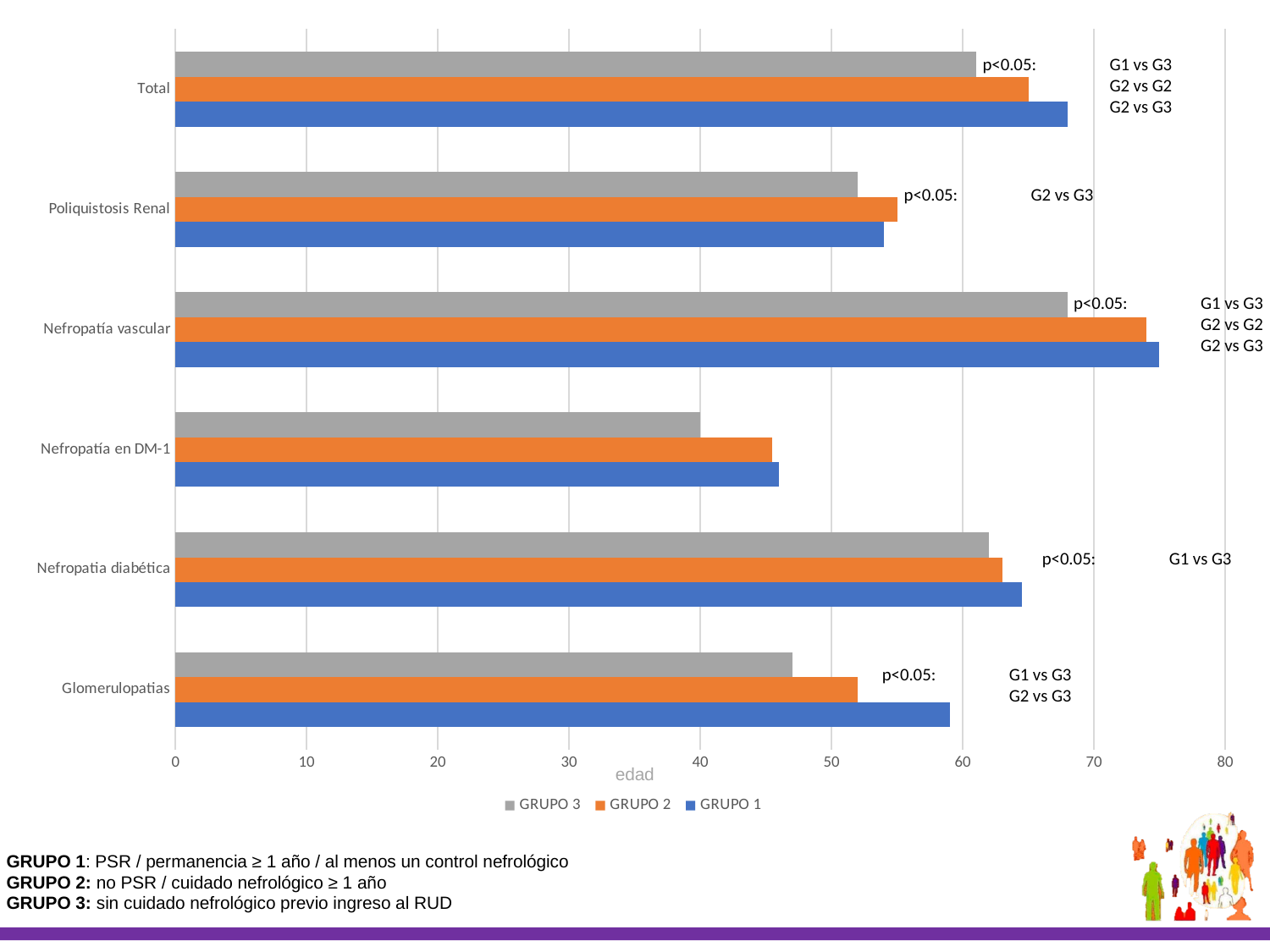
Is the GRUPO 3 value for Poliquistosis Renal greater or less than 60? less Is the GRUPO 3 value for Nefropatía en DM-1 greater or less than 50? less Is the GRUPO 1 value for Nefropatía vascular greater or less than 70? greater How many categories are shown on the vertical axis of the chart? 6 Which category has the lowest GRUPO 3 value? Nefropatía en DM-1 What kind of chart is shown on the slide? bar chart For Glomerulopatias, which is larger: the GRUPO 1 value or the GRUPO 3 value? GRUPO 1 What colour are the GRUPO 2 bars? orange Which category has the highest GRUPO 1 value? Nefropatía vascular What is the title of the horizontal axis? edad How many series does the legend list? 3